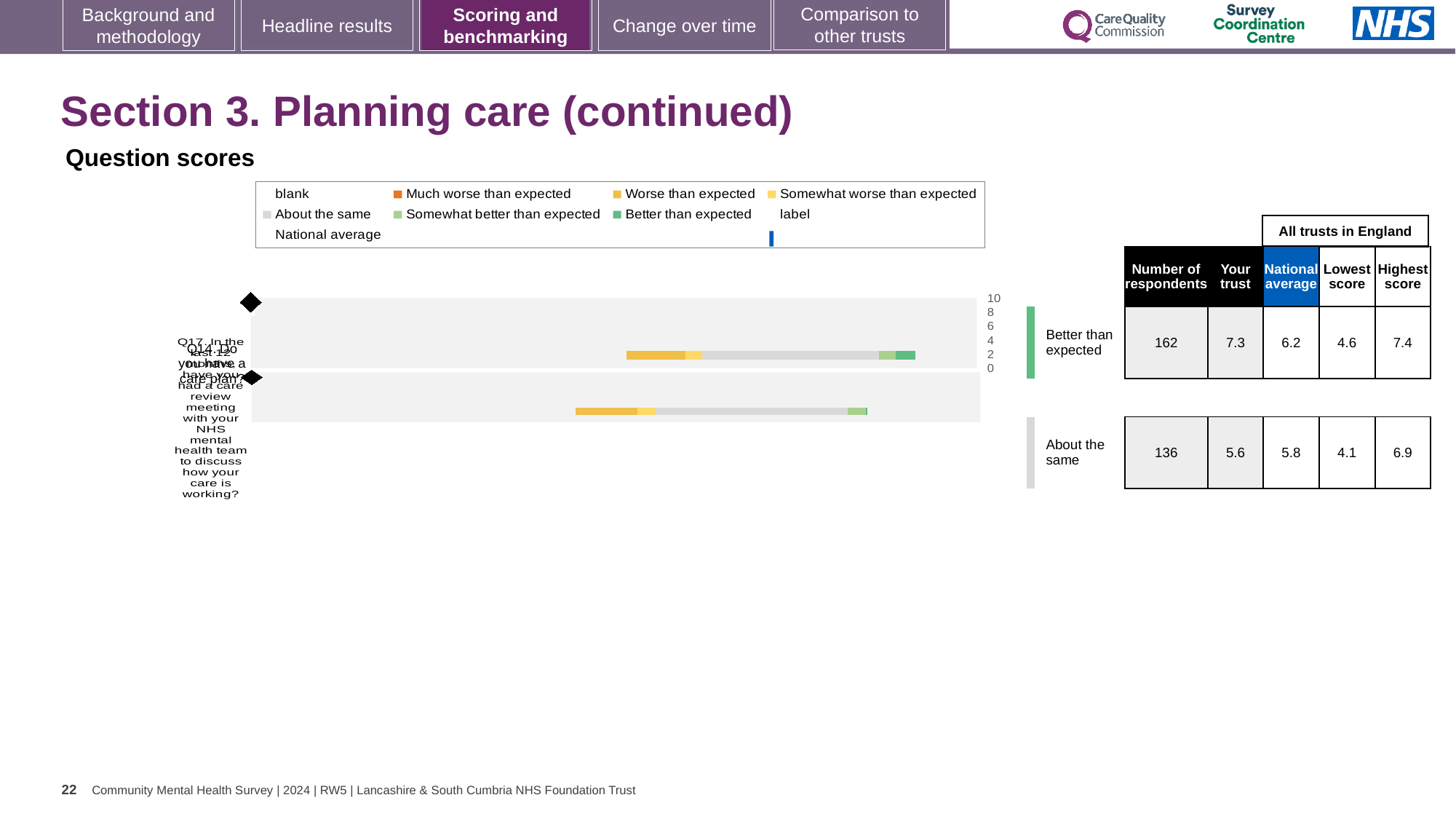
How many respondents answered the question rated 'Better than expected'? 162 How many respondents answered the question rated 'About the same'? 136 What is the highest score across all trusts in England for the row rated 'About the same'? 6.9 What kind of chart is shown under 'Question scores'? bar chart What is the maximum value shown on the chart's score axis? 10 What is the 'Your trust' score for the row rated 'Better than expected'? 7.3 Which row has the higher 'Your trust' score, 'Better than expected' or 'About the same'? Better than expected What is the 'Your trust' score for the row rated 'About the same'? 5.6 How many question rows are plotted in the chart? 2 What is the national average for the row rated 'About the same'? 5.8 What is the difference between the trust score and the national average for the row rated 'Better than expected'? 1.1 What is the national average for the row rated 'Better than expected'? 6.2